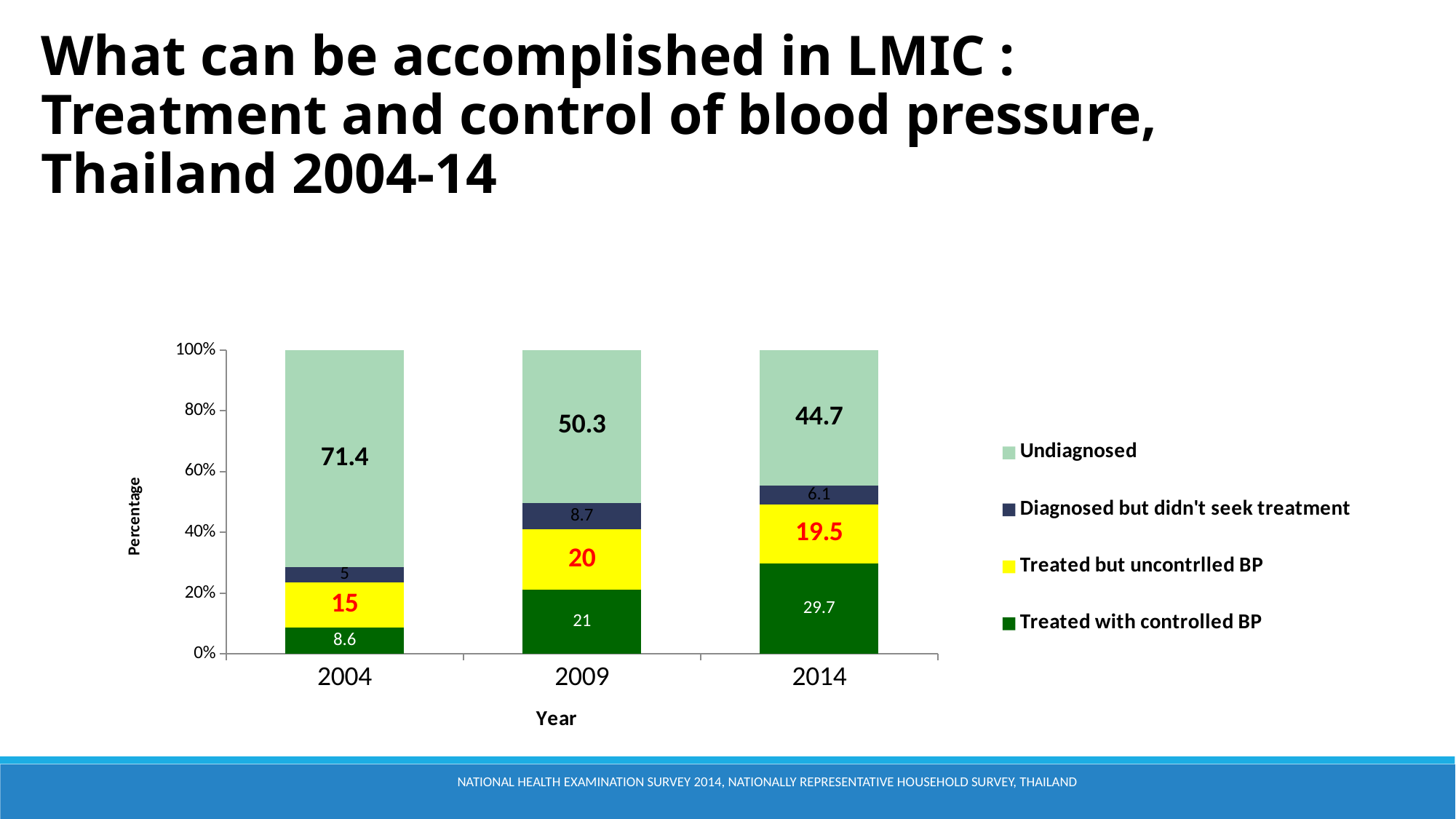
How many series does the legend list? 4 Which year has the highest Undiagnosed value? 2004 How many years are shown on the x axis? 3 What is the Treated but uncontrlled BP value for 2009? 20 What kind of chart is shown on the slide? Stacked bar chart Which is larger, the Diagnosed but didn't seek treatment value for 2009 or for 2014? 2009 Which year has the lowest Treated with controlled BP value? 2004 What is the Diagnosed but didn't seek treatment value for 2014? 6.1 Does the Undiagnosed value rise or fall from 2004 to 2014? Fall What is the difference between the Undiagnosed values for 2004 and 2014? 26.7 What is the Undiagnosed value for 2004? 71.4 What is the Treated with controlled BP value for 2014? 29.7